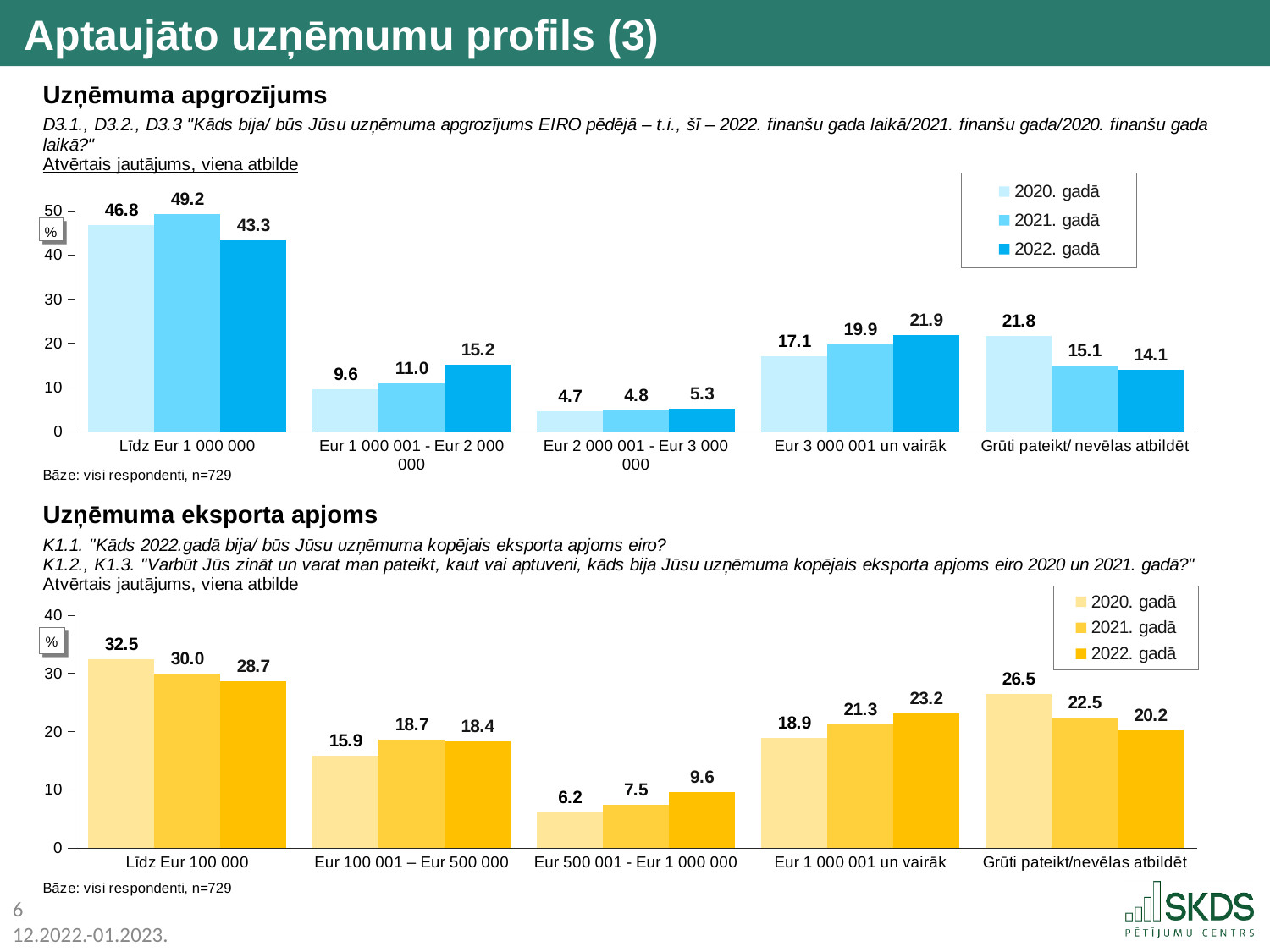
In the 'Uzņēmuma eksporta apjoms' chart, which category has the highest value in 2020. gadā? Līdz Eur 100 000 In the 'Uzņēmuma apgrozījums' chart, what is the difference between the 2021. gadā and 2020. gadā values for 'Līdz Eur 1 000 000'? 2.4 In the 'Uzņēmuma eksporta apjoms' chart, what is the value for 'Eur 500 001 - Eur 1 000 000' in 2022. gadā? 9.6 In the 'Uzņēmuma apgrozījums' chart, how many series does the legend list? 3 What kind of chart is the 'Uzņēmuma eksporta apjoms' chart? bar chart In the 'Uzņēmuma eksporta apjoms' chart, how many categories are shown on the x axis? 5 In the 'Uzņēmuma eksporta apjoms' chart, which is larger for 'Eur 100 001 – Eur 500 000': the 2021. gadā value or the 2022. gadā value? 2021. gadā In the 'Uzņēmuma eksporta apjoms' chart, what is the difference between the 2020. gadā and 2022. gadā values for 'Grūti pateikt/nevēlas atbildēt'? 6.3 In the 'Uzņēmuma apgrozījums' chart, what is the value for 'Līdz Eur 1 000 000' in 2022. gadā? 43.3 In the 'Uzņēmuma apgrozījums' chart, what is the value for 'Eur 3 000 001 un vairāk' in 2021. gadā? 19.9 In the 'Uzņēmuma apgrozījums' chart, which category has the lowest value in 2020. gadā? Eur 2 000 001 - Eur 3 000 000 In the 'Uzņēmuma apgrozījums' chart, do the values for 'Grūti pateikt/ nevēlas atbildēt' rise or fall from 2020. gadā to 2022. gadā? fall